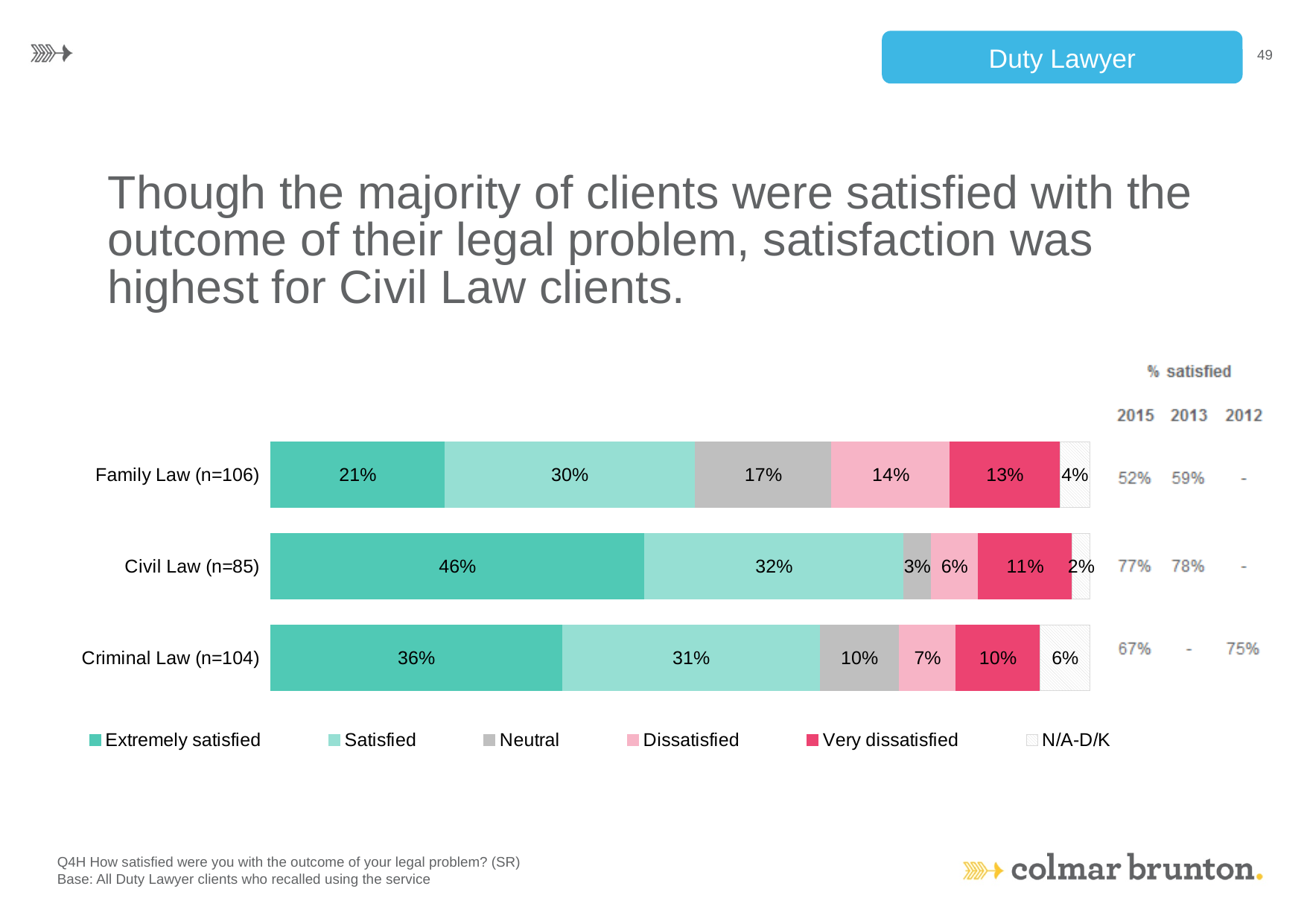
What percentage of Civil Law (n=85) clients were Extremely satisfied? 46% How many categories are shown in the chart? 3 Which has a larger Dissatisfied value, Family Law (n=106) or Criminal Law (n=104)? Family Law (n=106) Which category has the highest Extremely satisfied percentage? Civil Law (n=85) What kind of chart is shown on the slide? Stacked bar chart How many series does the legend list? 6 According to the % satisfied table, what was the 2015 % satisfied for Civil Law? 77% Which category has the lowest Very dissatisfied percentage? Criminal Law (n=104) What is the Neutral value for Family Law (n=106)? 17% What is the difference between the Satisfied values for Civil Law (n=85) and Family Law (n=106)? 2 percentage points What is the total of the stacked bar for Civil Law (n=85)? 100% What is the N/A-D/K value for Criminal Law (n=104)? 6%